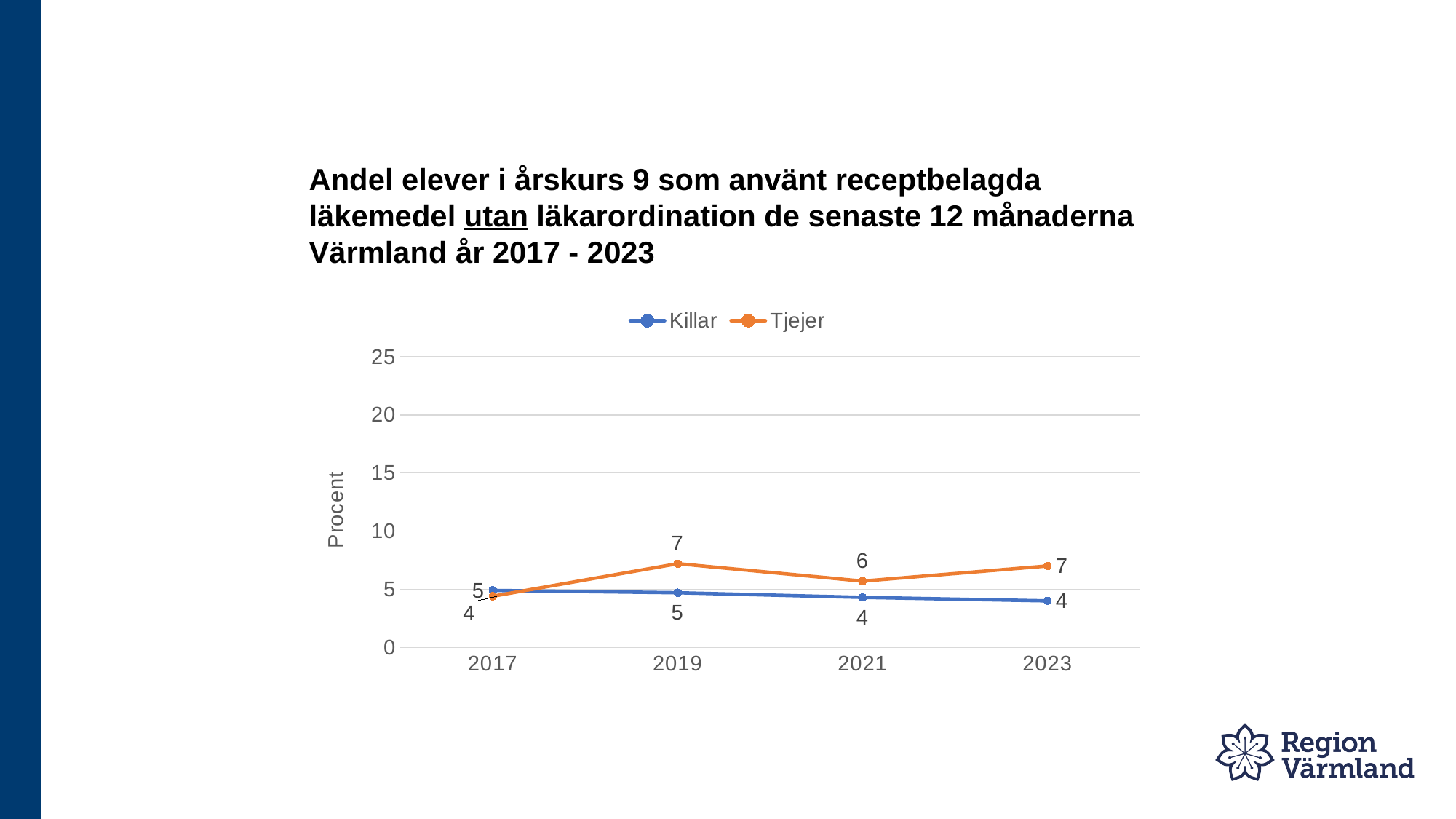
What value is shown for Tjejer in 2021? 6 In which year is the Tjejer value lowest? 2017 What is the label on the vertical axis? Procent How many series does the legend list? 2 What value is shown for Killar in 2023? 4 How many years are plotted on the x axis? 4 What kind of chart is shown on the slide? Line chart What value is shown for Tjejer in 2019? 7 What is the difference between the Tjejer and Killar values in 2023? 3 In 2021, which series has the higher value, Killar or Tjejer? Tjejer What value is shown for Killar in 2017? 5 Does the Killar series rise or fall from 2017 to 2023? Fall